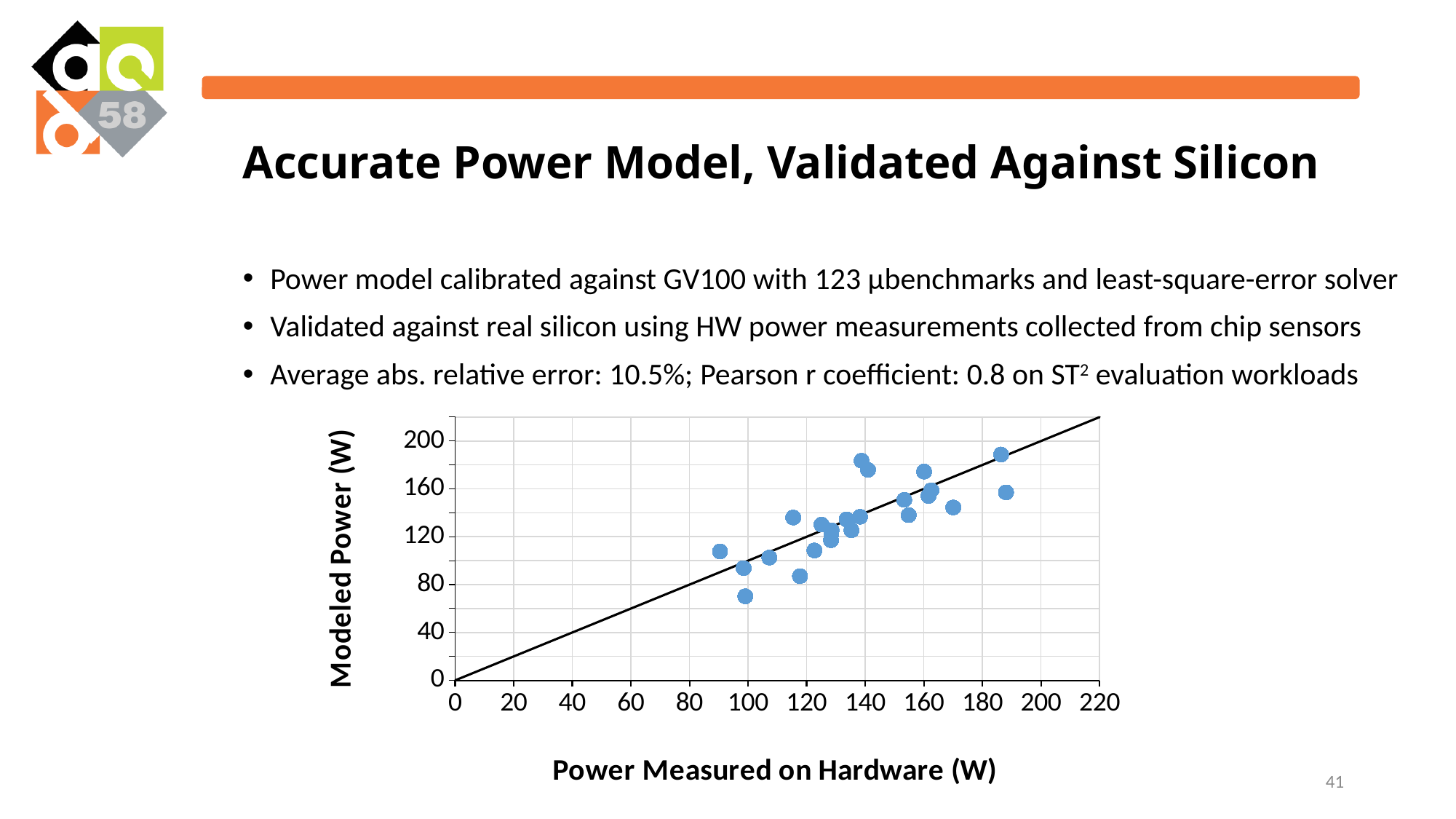
Is the largest measured hardware power among the plotted points greater or less than 200? less What is the title of the x axis of the chart? Power Measured on Hardware (W) What kind of chart is shown on the slide? Scatter chart As the power measured on hardware increases along the x axis, does the modeled power generally rise or fall? Rise What is the title of the y axis of the chart? Modeled Power (W) Is the highest modeled power value among the plotted points greater or less than 180? greater What is the highest tick value shown on the x axis of the chart? 220 What is the highest tick value shown on the y axis of the chart? 200 Is the lowest modeled power value among the plotted points greater or less than 80? less